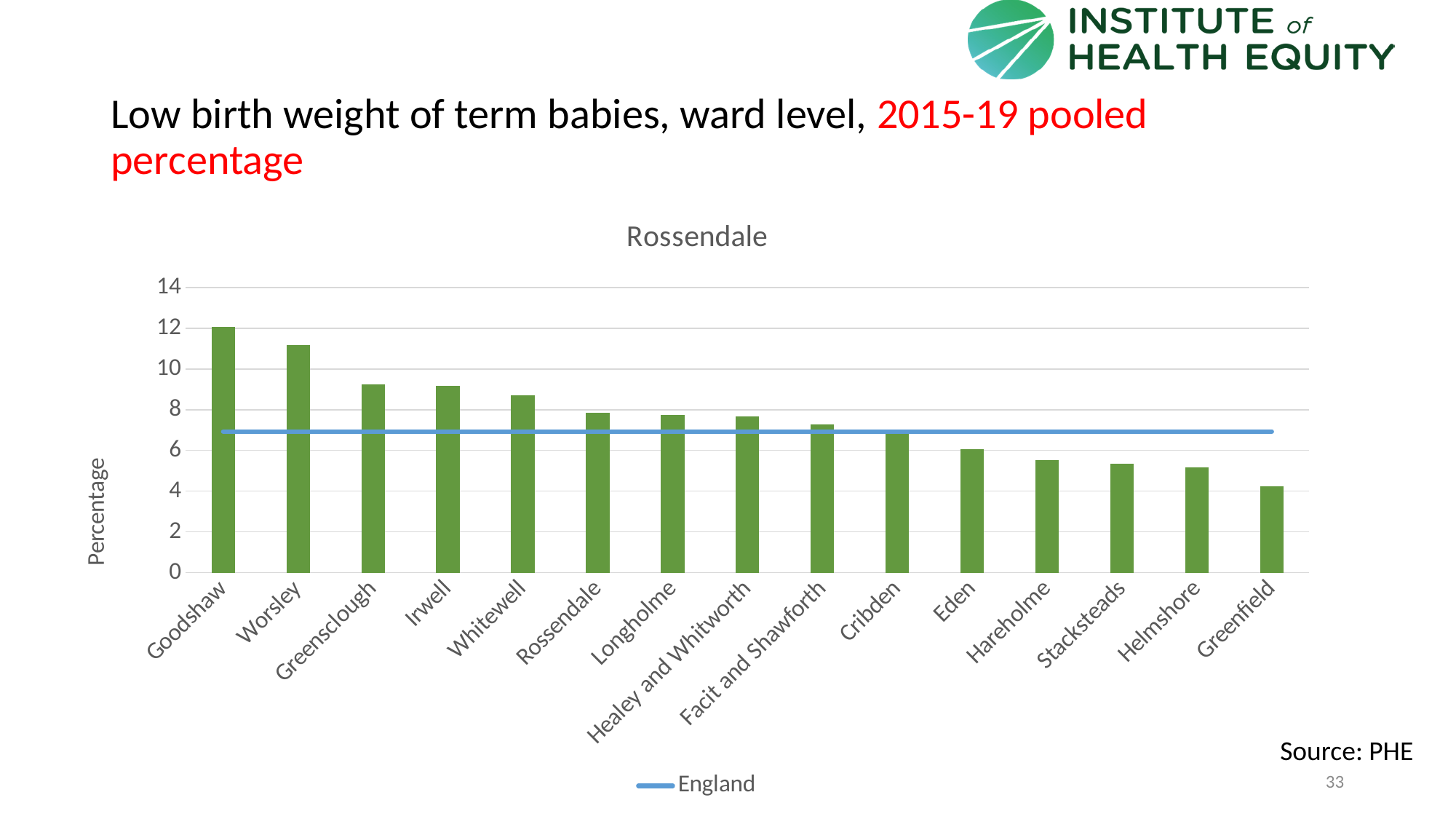
Is the value for Goodshaw greater or less than 10? greater Is the value for Whitewell greater or less than 8? greater What does the horizontal blue line in the chart represent, according to the legend? England Is the value for Greenfield greater or less than 6? less How many wards are shown on the x axis of the chart? 15 Which ward has the lowest low birth weight percentage in the chart? Greenfield Which has a higher value, Worsley or Eden? Worsley What type of chart is shown on the slide? Bar chart Do the bar values rise or fall moving from left to right along the x axis? Fall Which ward has the highest low birth weight percentage in the chart? Goodshaw How many entries does the chart legend list? 1